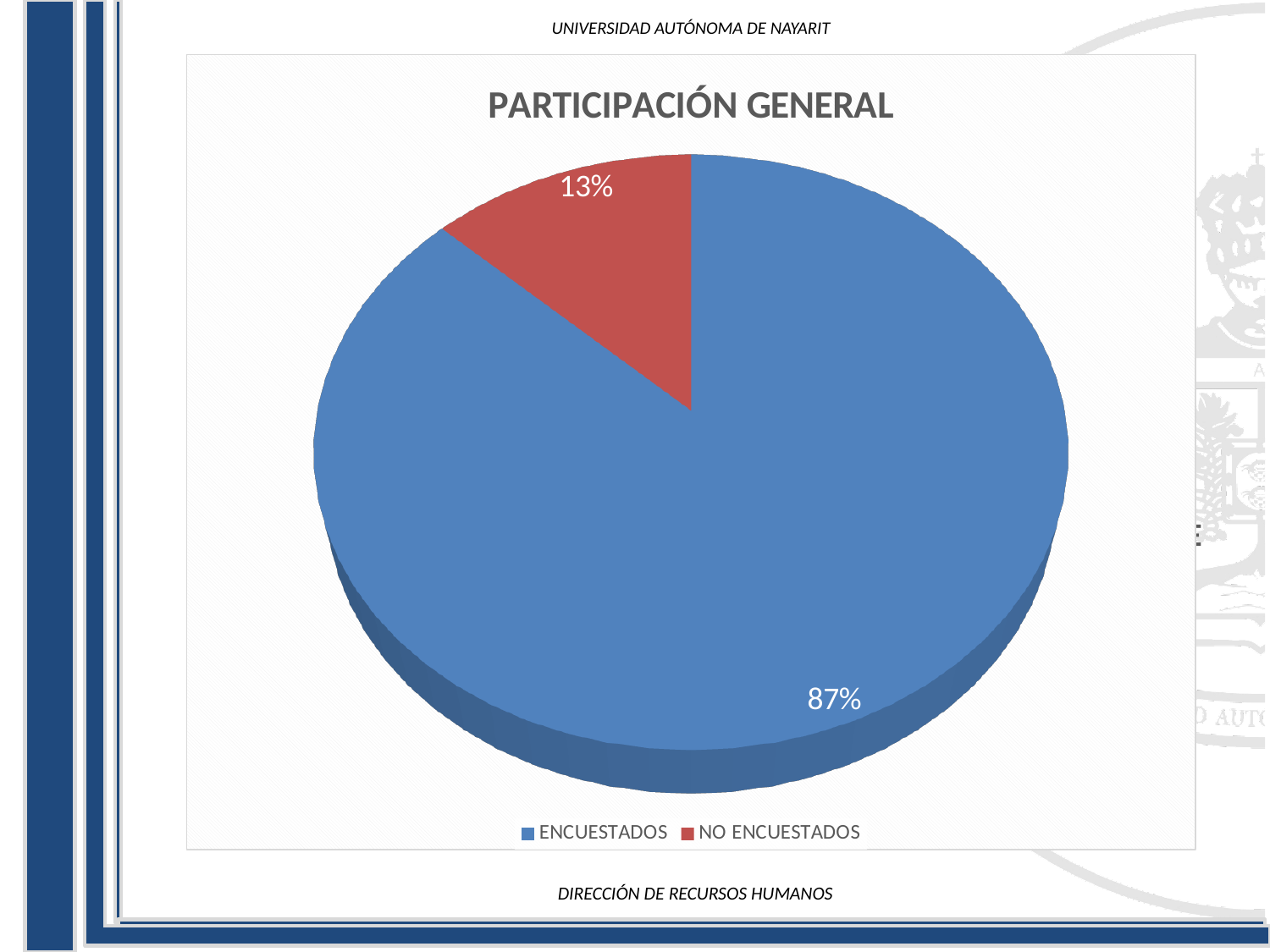
What colour is the NO ENCUESTADOS slice? Red How many entries does the legend list? 2 What type of chart is shown on the slide? Pie chart Which category has the largest share of the pie? ENCUESTADOS What percentage of the pie is NO ENCUESTADOS? 13% How many slices does the pie chart have? 2 Which category has the smallest share of the pie? NO ENCUESTADOS What is the title of the chart? PARTICIPACIÓN GENERAL Which is larger, the share for ENCUESTADOS or the share for NO ENCUESTADOS? ENCUESTADOS What is the difference in percentage points between ENCUESTADOS and NO ENCUESTADOS? 74 What percentage of the pie is ENCUESTADOS? 87%